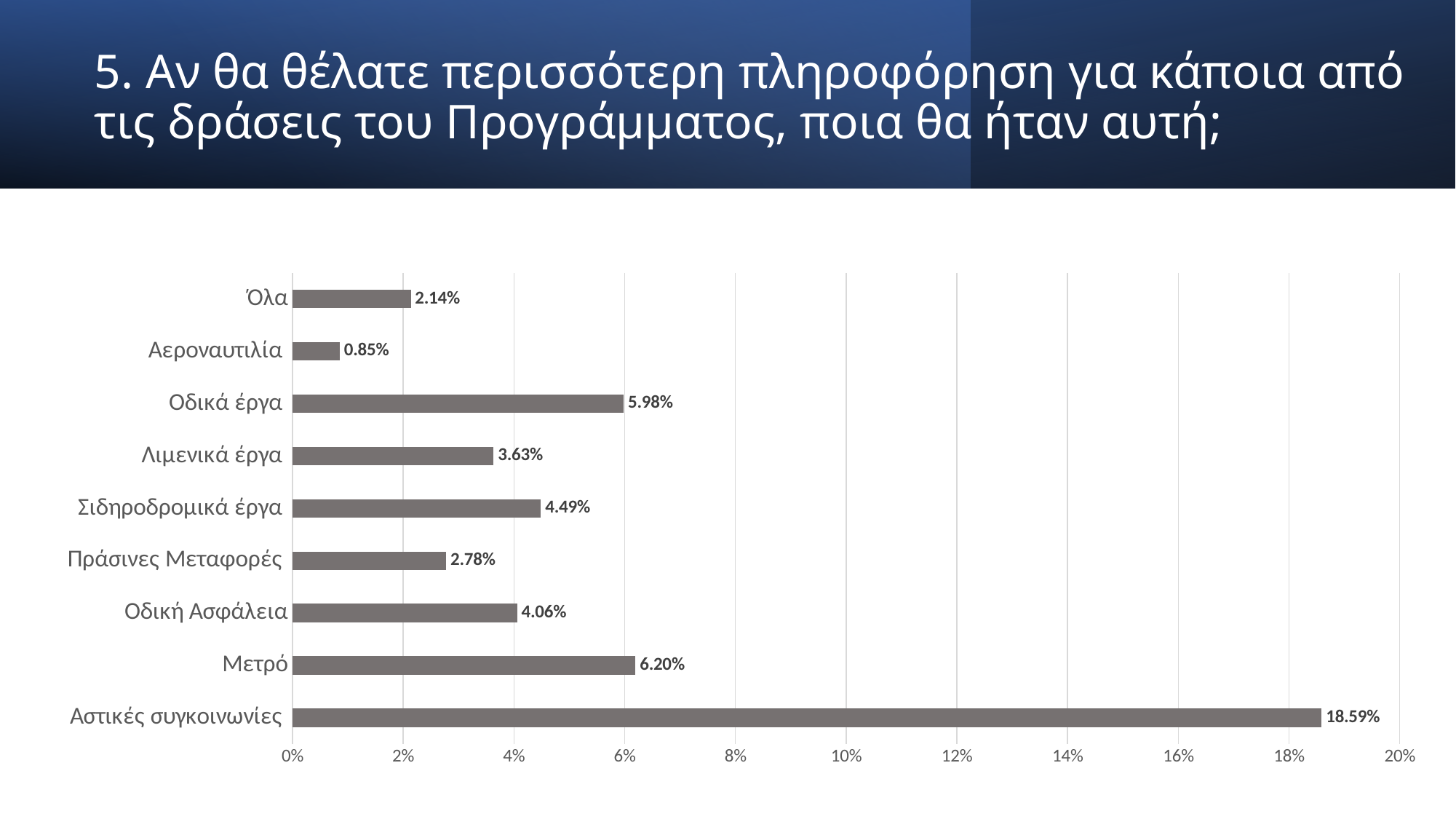
What is the value for Αστικές συγκοινωνίες? 18.59% Which category has the lowest value? Αεροναυτιλία What is the difference between the values for Οδικά έργα and Λιμενικά έργα? 2.35% Which category has the highest value? Αστικές συγκοινωνίες Which is larger, the value for Σιδηροδρομικά έργα or the value for Οδική Ασφάλεια? Σιδηροδρομικά έργα Is the value for Οδικά έργα greater or less than 4%? greater What is the value for Μετρό? 6.20% What is the difference between the values for Αστικές συγκοινωνίες and Μετρό? 12.39% How many categories are shown in the chart? 9 What kind of chart is shown on the slide? bar chart What is the value for Πράσινες Μεταφορές? 2.78% What is the value for Λιμενικά έργα? 3.63%